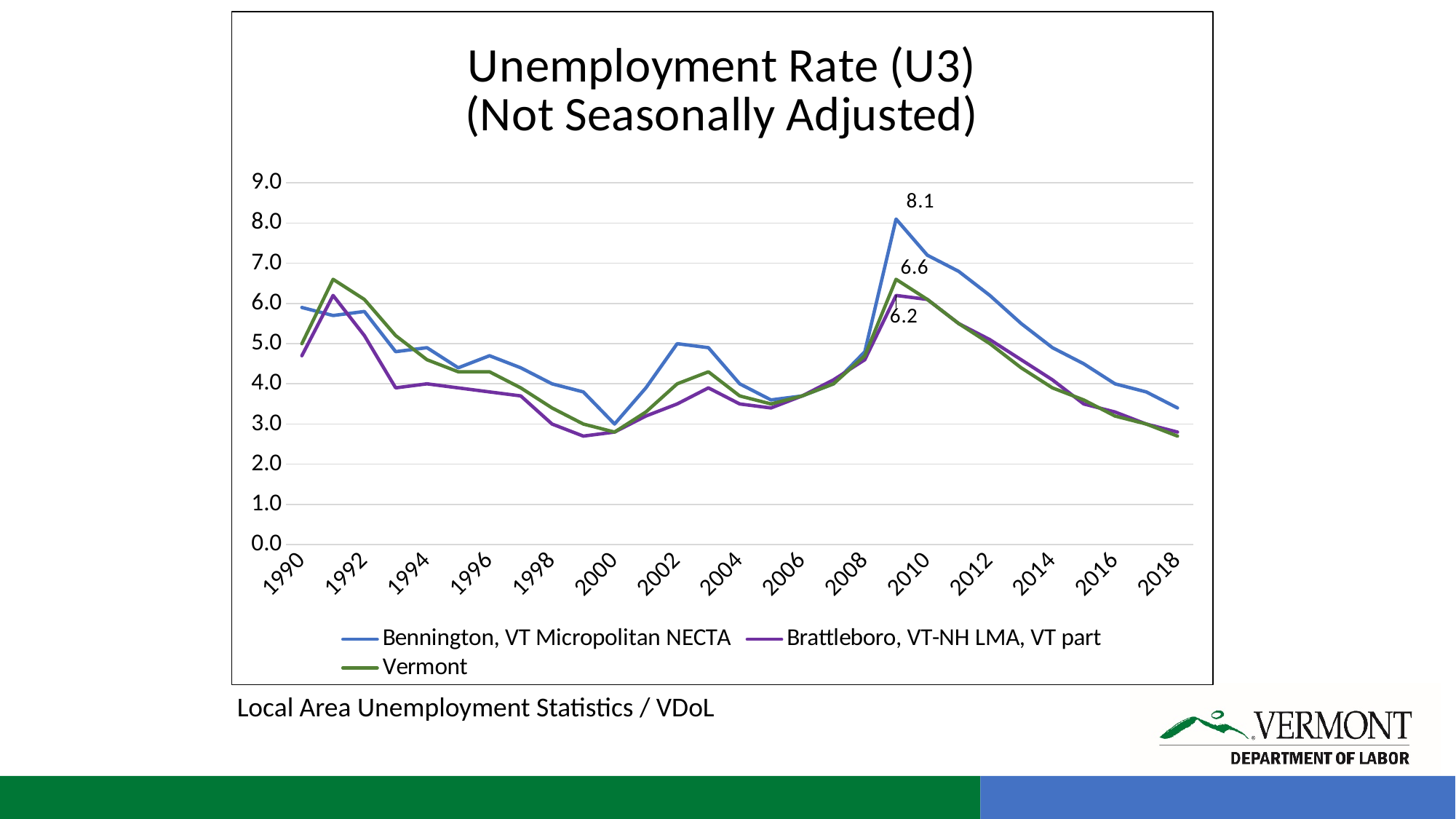
Do the unemployment rates rise or fall between 2010 and 2018? fall How many series does the legend list? 3 Which series reaches the highest unemployment rate on the chart? Bennington, VT Micropolitan NECTA What kind of chart is shown on the slide? line chart At the labelled peaks, which is larger: the Bennington value or the Brattleboro value? Bennington Is the value for Bennington, VT Micropolitan NECTA in 1990 greater or less than 5.0? greater What is the labelled peak value of the Vermont line? 6.6 Is the value for Bennington, VT Micropolitan NECTA in 2018 greater or less than 4.0? less What is the difference between the labelled peak of Vermont (6.6) and the labelled peak of Brattleboro (6.2)? 0.4 What is the highest value reached by the Bennington, VT Micropolitan NECTA line? 8.1 What is the labelled peak value of the Brattleboro, VT-NH LMA, VT part line? 6.2 What is the difference between the labelled peak of Bennington (8.1) and the labelled peak of Vermont (6.6)? 1.5